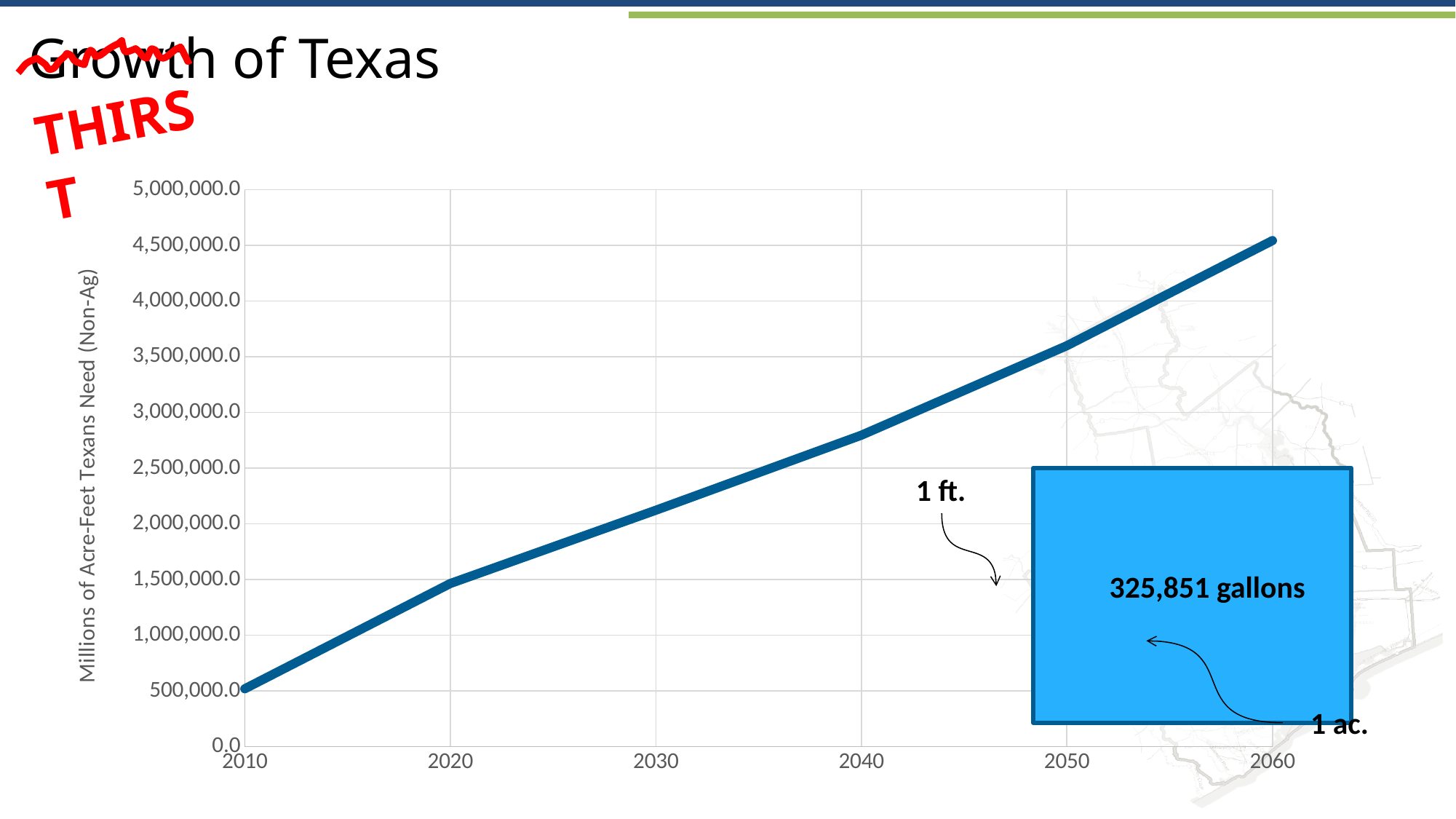
Which year on the x axis has the highest value? 2060 How many year labels are shown on the x axis? 6 What kind of chart is shown on the slide? line chart Is the value for 2010 greater or less than 1,000,000.0? less Which year on the x axis has the lowest value? 2010 Is the value for 2060 greater or less than 4,000,000.0? greater What is the title of the y axis? Millions of Acre-Feet Texans Need (Non-Ag) Is the value for 2020 greater or less than 1,000,000.0? greater Which is larger, the value for 2040 or the value for 2020? 2040 Do the values on the chart rise or fall from 2010 to 2060? rise